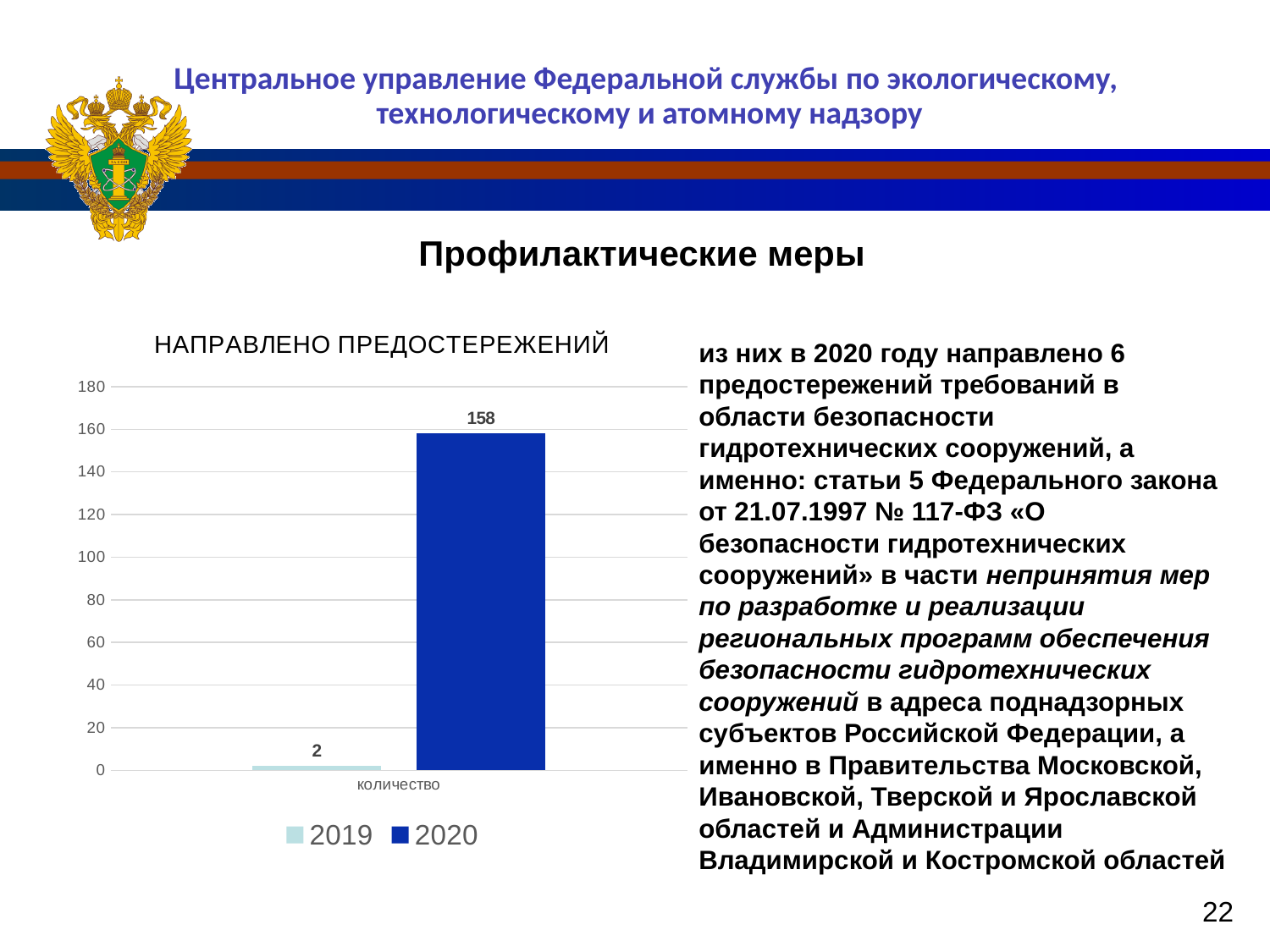
What is the category label on the x axis of the chart? количество What is the value for 2019 in the chart 'НАПРАВЛЕНО ПРЕДОСТЕРЕЖЕНИЙ'? 2 Which series has the higher value, 2019 or 2020? 2020 What kind of chart is shown on the slide? bar chart Is the value for 2019 greater or less than 20? less How many series does the legend list? 2 What is the value for 2020 in the chart 'НАПРАВЛЕНО ПРЕДОСТЕРЕЖЕНИЙ'? 158 Which series has the lowest value in the chart? 2019 What is the difference between the 2020 and 2019 values? 156 What is the highest value shown on the y axis of the chart? 180 What is the title of the chart? НАПРАВЛЕНО ПРЕДОСТЕРЕЖЕНИЙ Is the value for 2020 greater or less than 140? greater